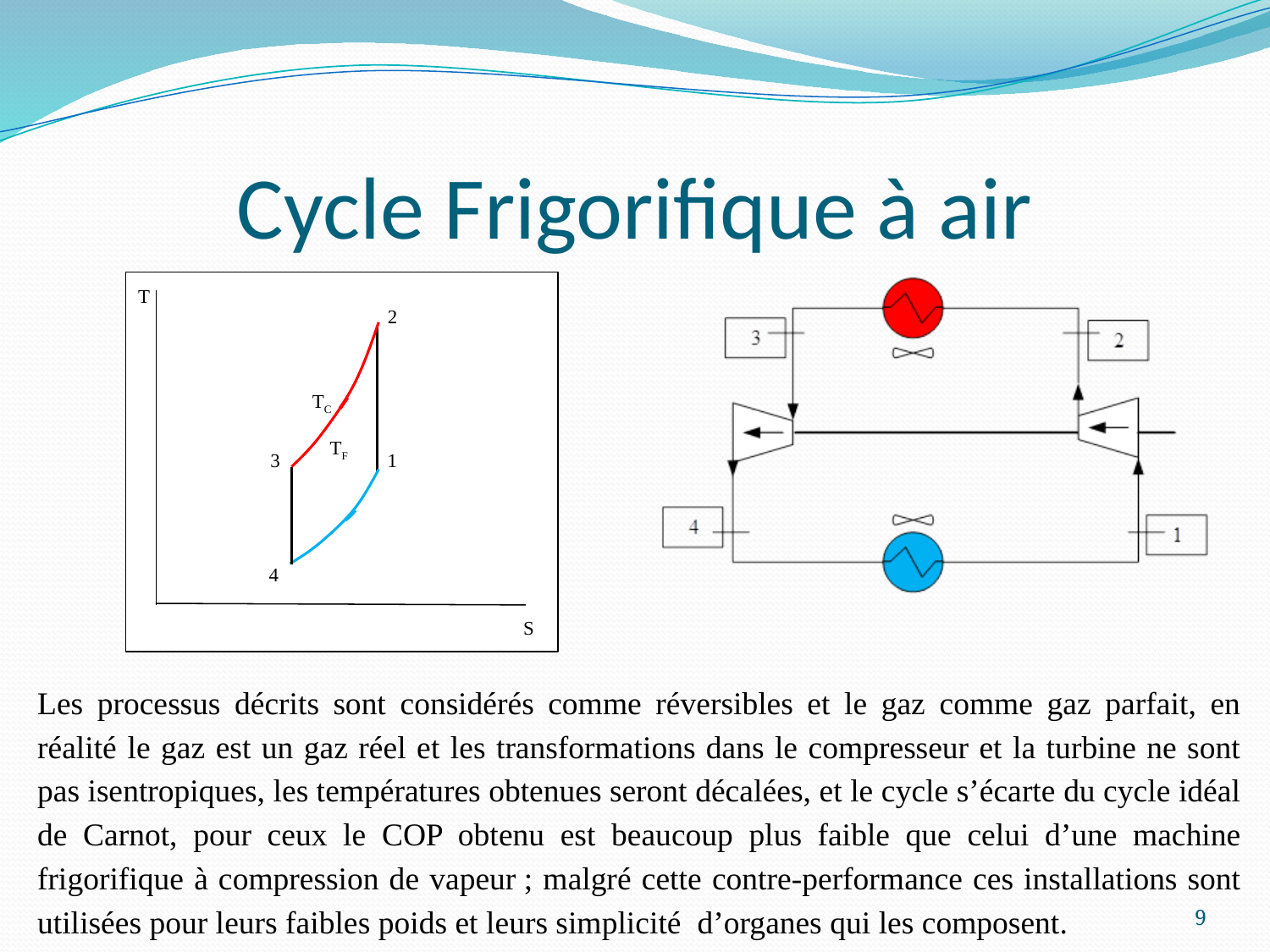
What label is on the vertical axis of the diagram on the left? T What label is on the horizontal axis of the diagram on the left? S How many numbered state points are marked on the T-S diagram? 4 On the T-S diagram, which numbered state point is at the lowest temperature? 4 On the T-S diagram, which is at a higher temperature, point 2 or point 1? Point 2 On the T-S diagram, which is at a higher temperature, point 3 or point 4? Point 3 On the T-S diagram, which numbered state point is at the highest temperature? 2